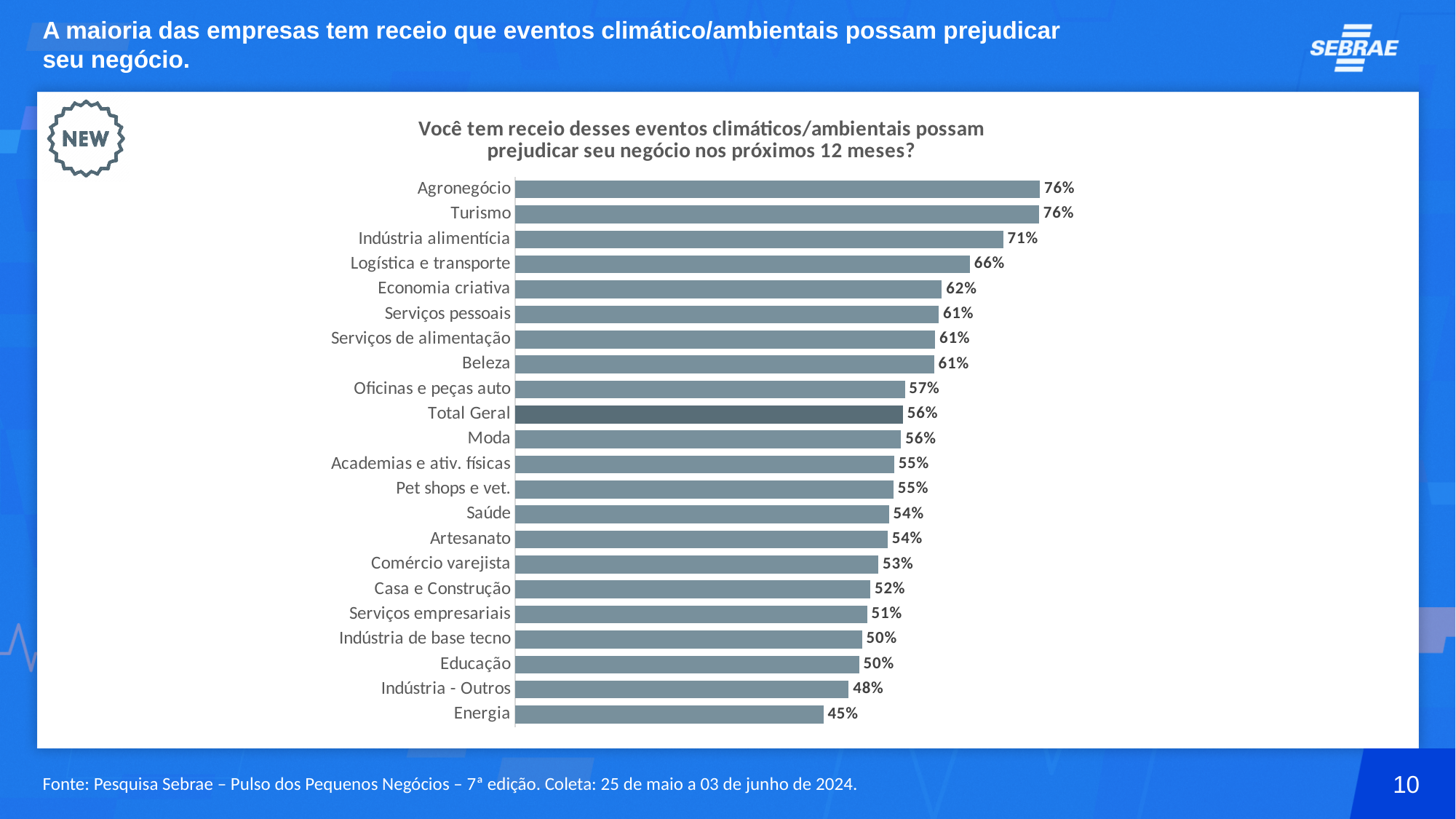
What is the difference between the values for Agronegócio and Energia? 31% What is the value for Total Geral? 56% What is the value for Indústria alimentícia? 71% What is the value for Logística e transporte? 66% What is the value for Energia? 45% What kind of chart is shown on the slide? Bar chart Which is larger, the value for Indústria - Outros or the value for Comércio varejista? Comércio varejista How many categories are shown in the chart? 22 Which category has the lowest value? Energia What is the difference between the values for Economia criativa and Total Geral? 6% Which bar is shown in a darker colour than the others? Total Geral Which is larger, the value for Oficinas e peças auto or the value for Educação? Oficinas e peças auto